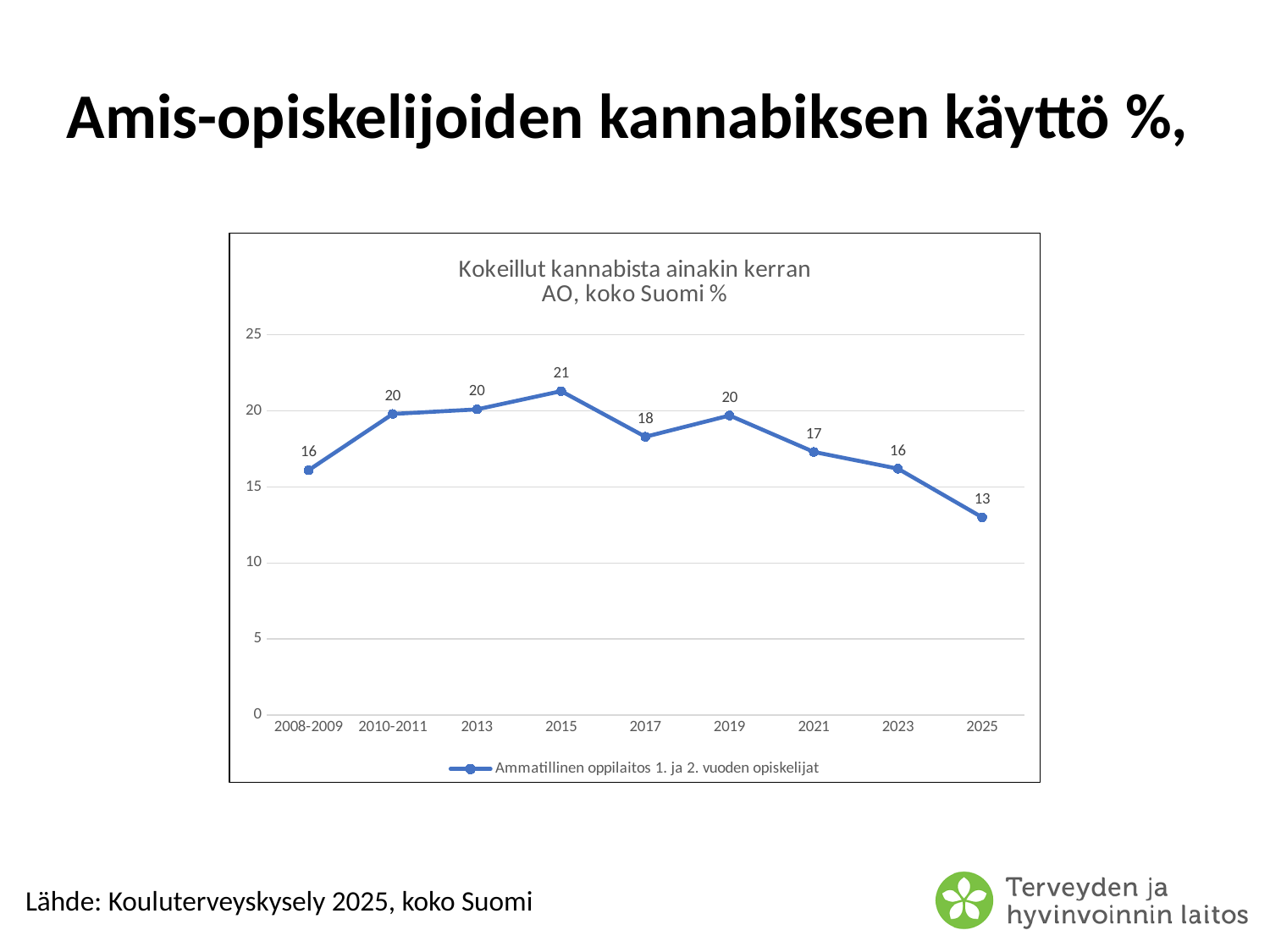
How many series does the legend list? 1 What kind of chart is shown? line chart How many points are plotted on the line? 9 Which year has the highest value? 2015 What is the title of the chart? Kokeillut kannabista ainakin kerran AO, koko Suomi % Is the value for 2021 greater or less than 20? less What is the value for 2015? 21 What is the value for 2008-2009? 16 What is the difference between the values for 2015 and 2025? 8 What is the value for 2025? 13 Which is larger, the value for 2017 or the value for 2019? 2019 Which year has the lowest value? 2025